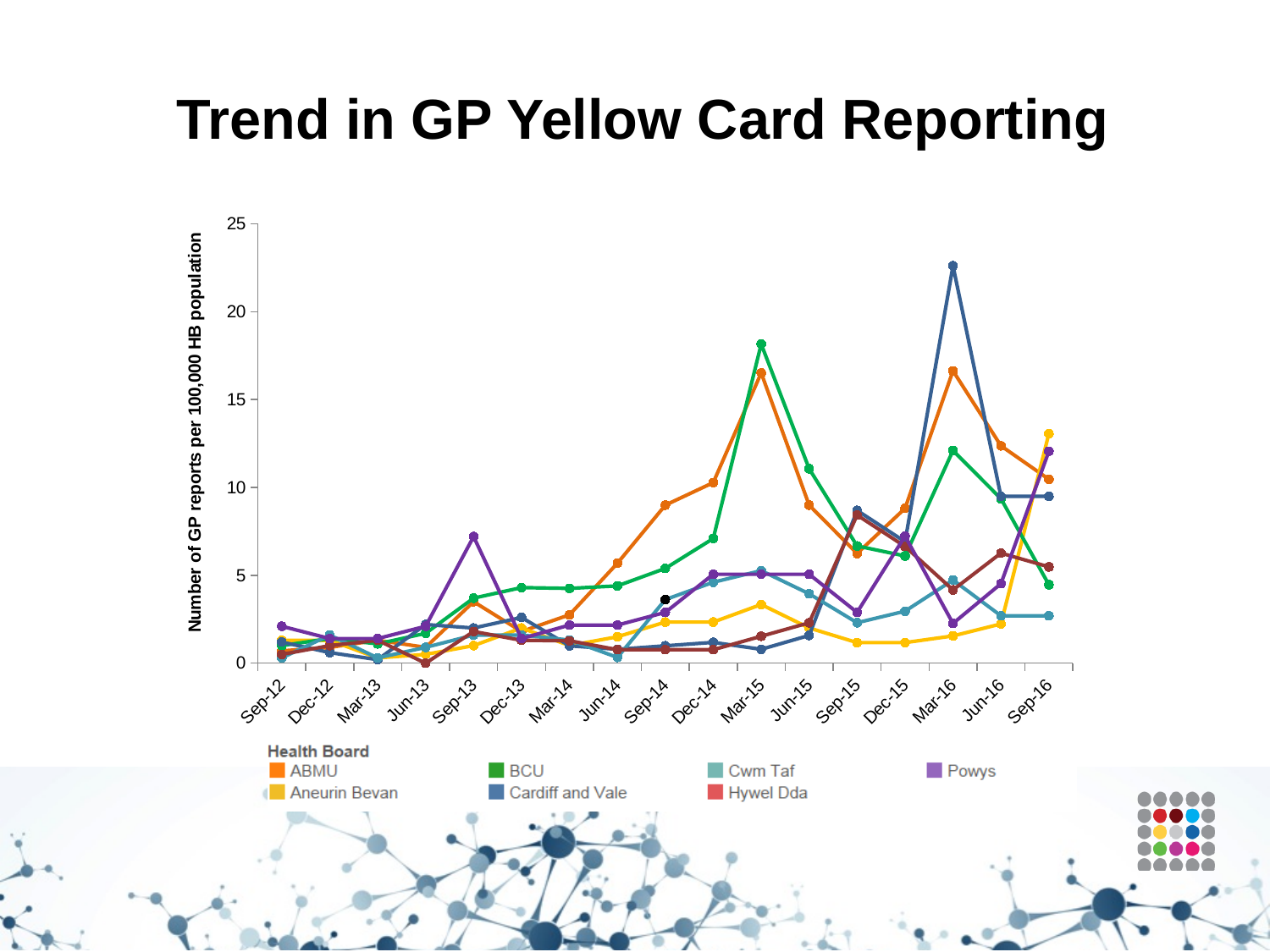
Does the ABMU line rise or fall between Jun-14 and Mar-15? Rise How many health boards does the legend list? 7 Is the value for Cwm Taf at Sep-16 greater or less than 5? less What is the label on the y axis? Number of GP reports per 100,000 HB population In which quarter does the highest single value on the chart occur? Mar-16 Which health board reaches the highest value anywhere on the chart? Cardiff and Vale Is the value for Cardiff and Vale at Mar-16 greater or less than 20? greater How many time points are shown along the x axis? 17 Is the value for BCU at Mar-15 greater or less than 15? greater What kind of chart is shown on the slide? Line chart At Mar-16, which is larger: the value for Cardiff and Vale or the value for ABMU? Cardiff and Vale